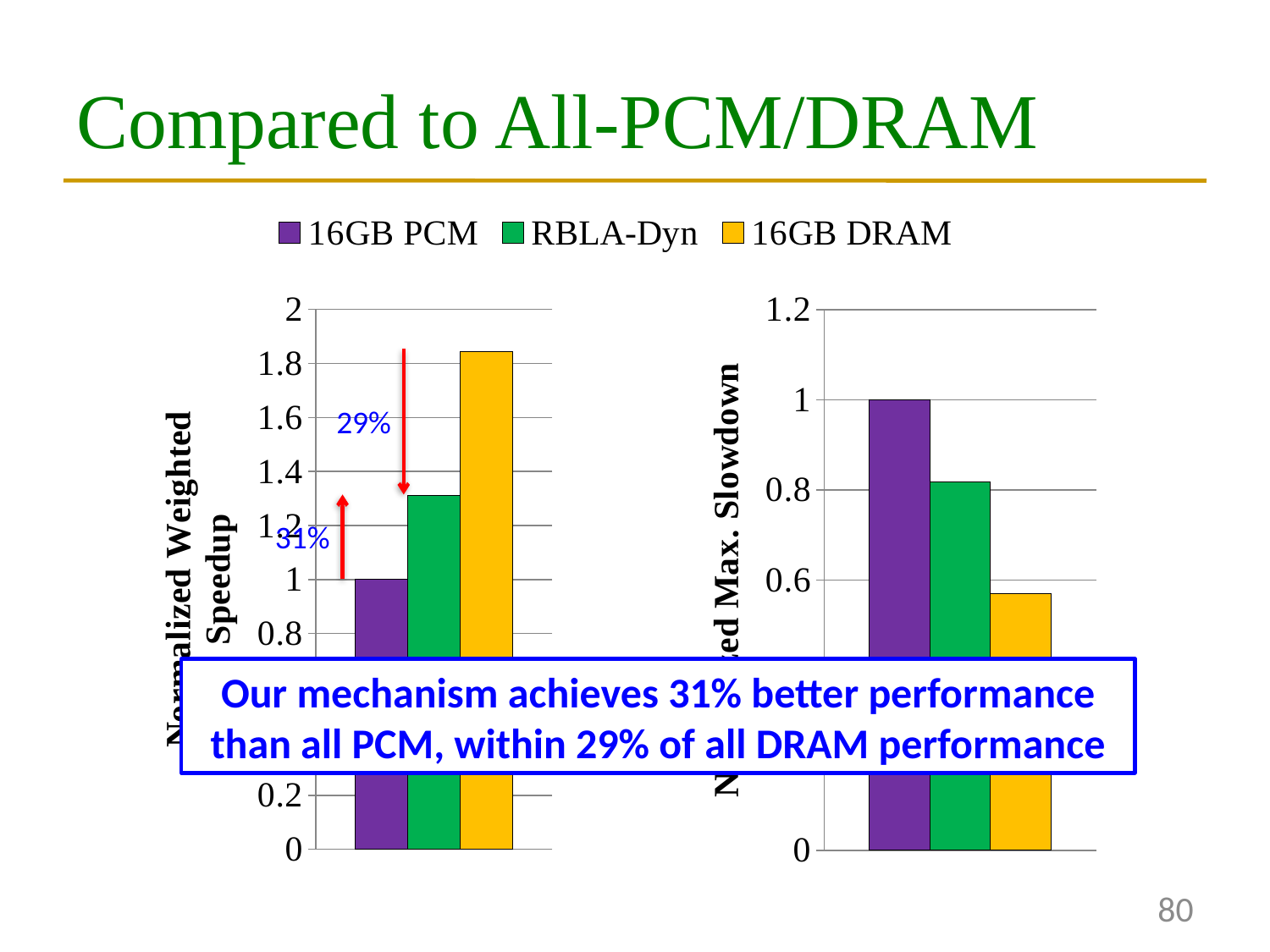
In the right chart (Normalized Max. Slowdown), which series has the lowest value? 16GB DRAM In the left chart (Normalized Weighted Speedup), is the value for 16GB DRAM greater or less than 1.6? greater In the right chart (Normalized Max. Slowdown), which series has the highest value? 16GB PCM What kind of chart is the left chart (Normalized Weighted Speedup)? bar chart In the left chart (Normalized Weighted Speedup), which series has the lowest value? 16GB PCM In the right chart (Normalized Max. Slowdown), is the value for 16GB DRAM greater or less than 0.6? less In the right chart (Normalized Max. Slowdown), which is larger, the value for RBLA-Dyn or the value for 16GB DRAM? RBLA-Dyn In the right chart (Normalized Max. Slowdown), what is the value for 16GB PCM? 1 In the left chart (Normalized Weighted Speedup), what is the value for 16GB PCM? 1 How many series does the legend list? 3 In the left chart (Normalized Weighted Speedup), which series has the highest value? 16GB DRAM In the left chart (Normalized Weighted Speedup), is the value for RBLA-Dyn greater or less than 1.4? less